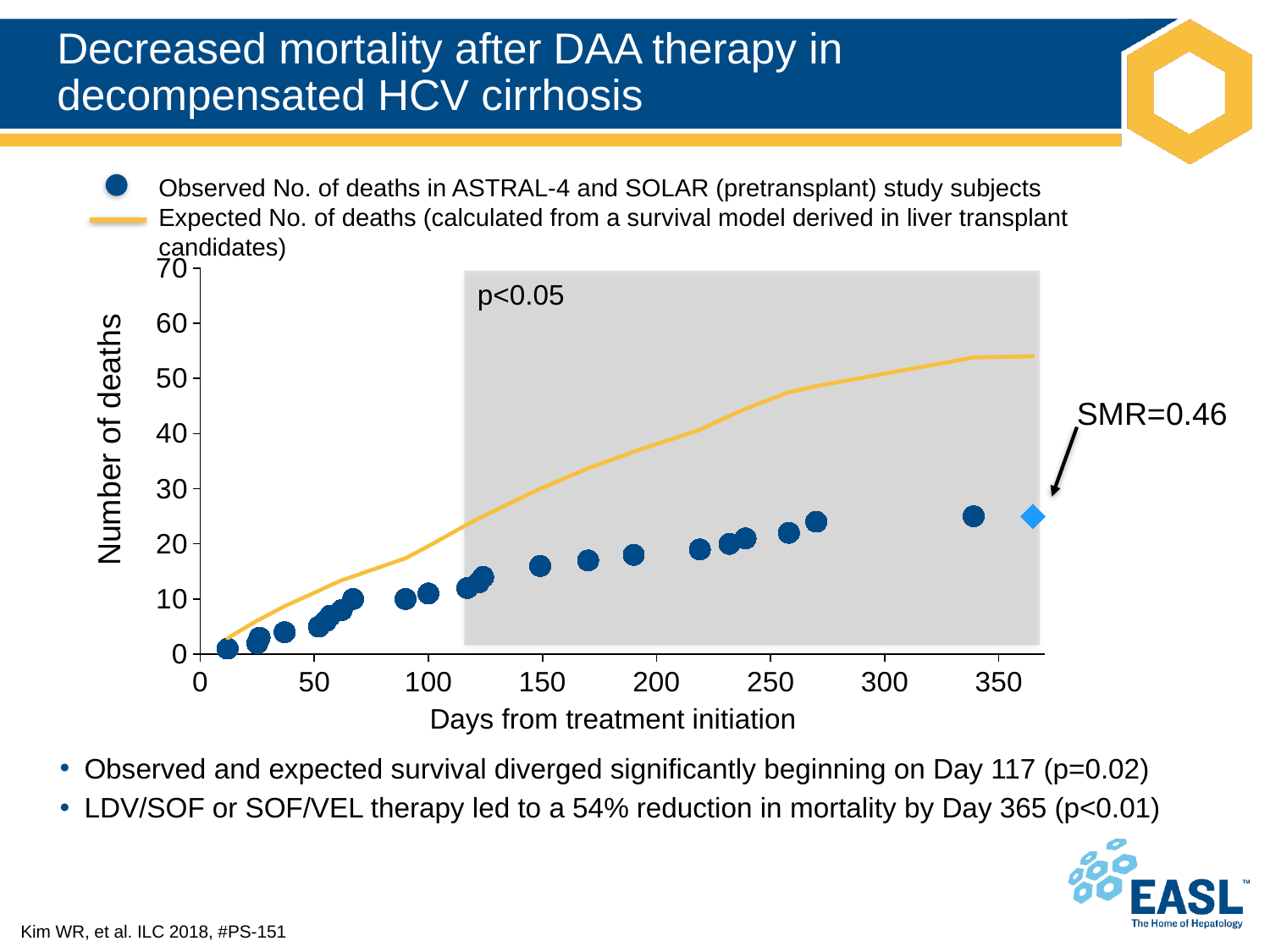
What is the label of the y axis? Number of deaths Which series reaches the higher number of deaths by the end of the x axis? Expected No. of deaths Is the observed number of deaths at around day 340 greater or less than 30? less What SMR value is annotated on the chart? SMR=0.46 How many series does the legend list? 2 At day 250, which is larger: the expected number of deaths or the observed number of deaths? Expected number of deaths What is the label of the x axis? Days from treatment initiation What kind of chart is shown on the slide? Line chart with scatter points Is the observed number of deaths at around day 150 greater or less than 20? less Is the expected number of deaths at day 200 greater or less than 30? greater Does the expected number of deaths rise or fall as days from treatment initiation increase? Rise